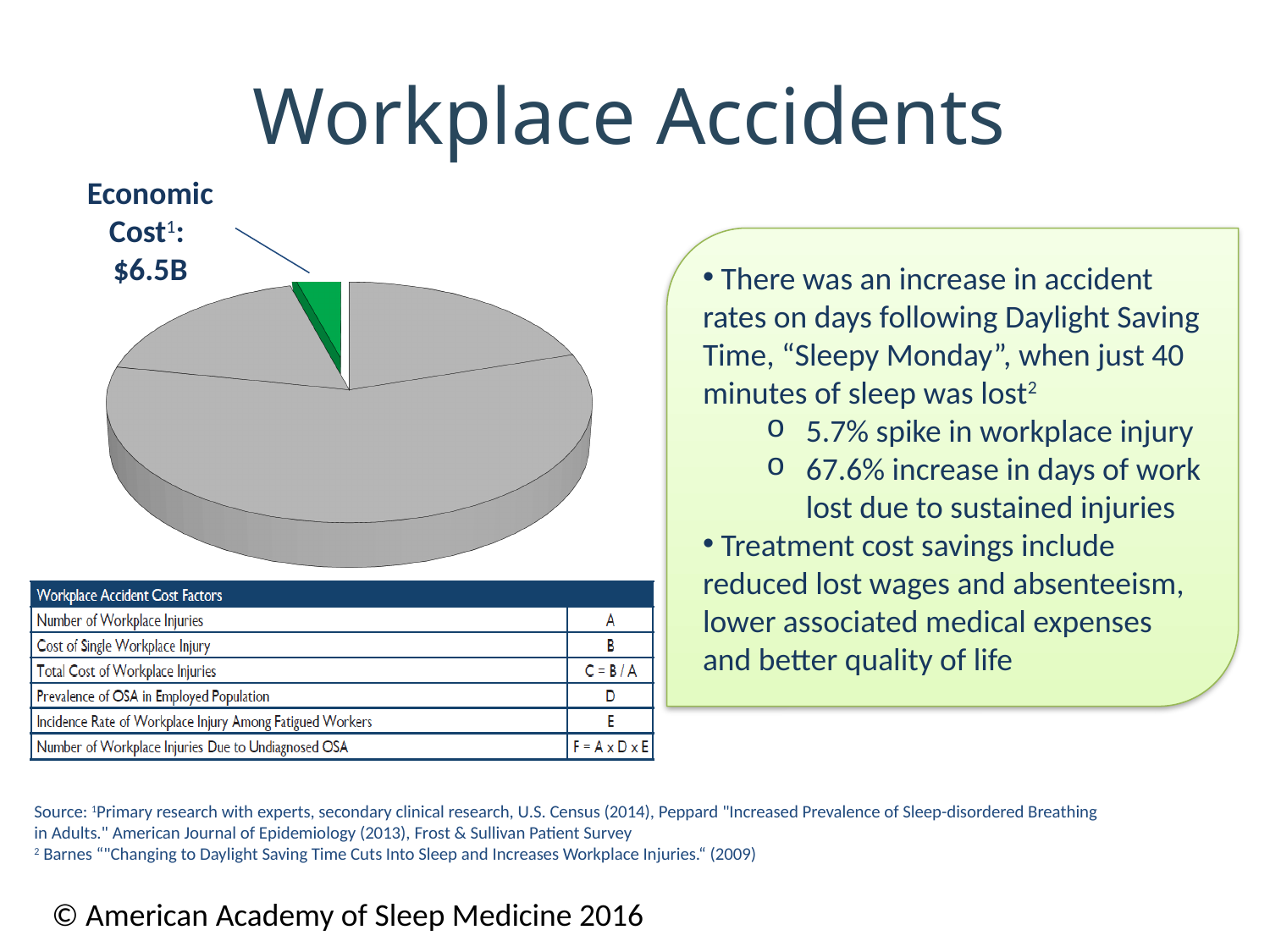
How many slices does the pie chart have? 4 What kind of chart is shown on the slide? pie chart Is the green Economic Cost slice larger or smaller than the large gray slice at the bottom of the pie chart? smaller What is the title of the slide containing the pie chart? Workplace Accidents What value is labelled for the Economic Cost slice of the pie chart? $6.5B What colour is the slice of the pie chart that is labelled Economic Cost? green Which slice of the pie chart is the smallest? Economic Cost ($6.5B)